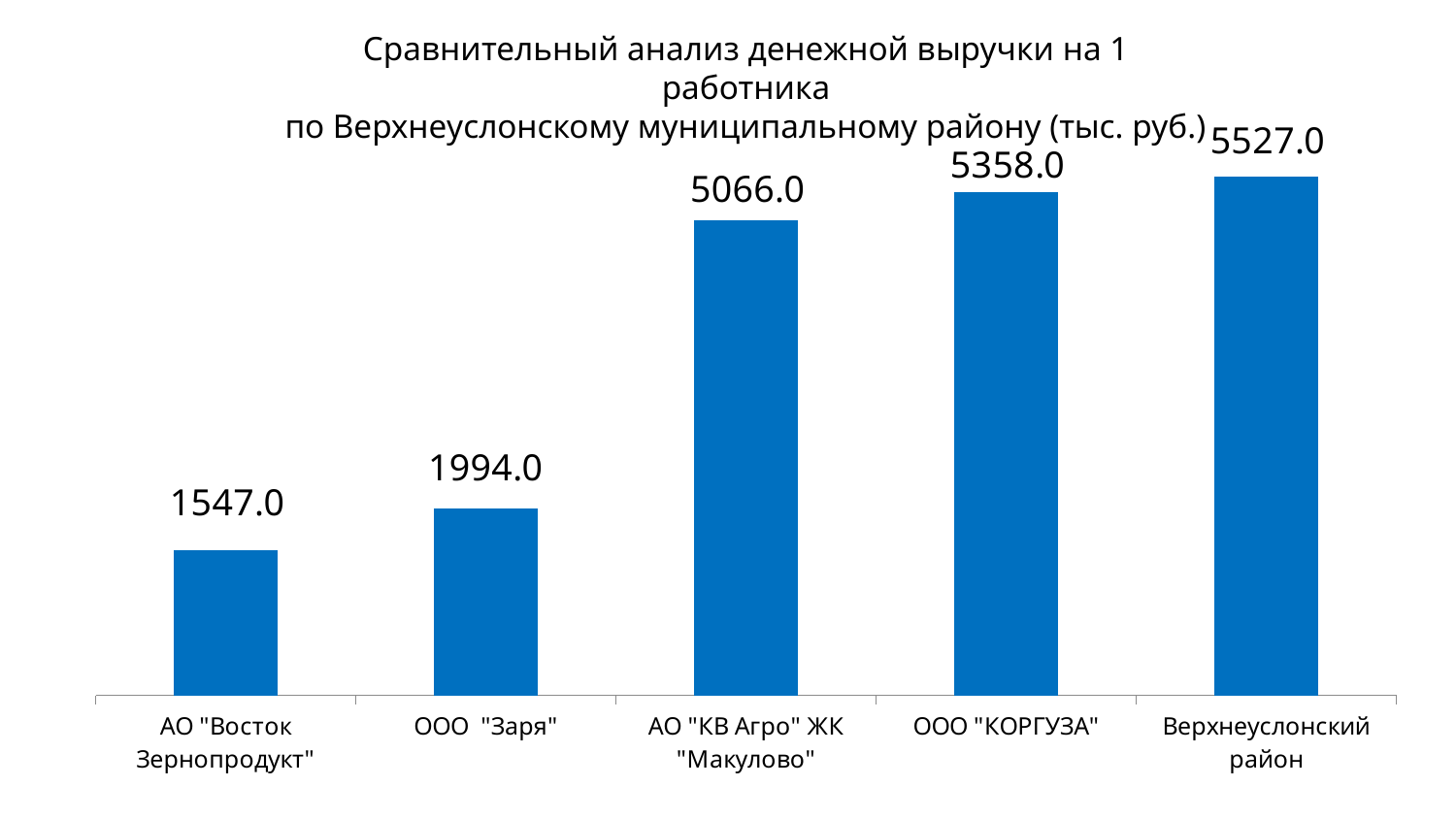
Which category has the lowest value? АО "Восток Зернопродукт" What is the value for АО "КВ Агро" ЖК "Макулово"? 5066.0 What is the difference between the values for Верхнеуслонский район and АО "Восток Зернопродукт"? 3980.0 What is the difference between the values for ООО "КОРГУЗА" and АО "КВ Агро" ЖК "Макулово"? 292.0 What is the value for АО "Восток Зернопродукт"? 1547.0 How many categories are shown on the chart? 5 What is the value for Верхнеуслонский район? 5527.0 Which category has the highest value? Верхнеуслонский район Which is larger, the value for ООО "Заря" or the value for АО "КВ Агро" ЖК "Макулово"? АО "КВ Агро" ЖК "Макулово" What is the value for ООО "Заря"? 1994.0 What is the value for ООО "КОРГУЗА"? 5358.0 What kind of chart is shown on the slide? Bar chart